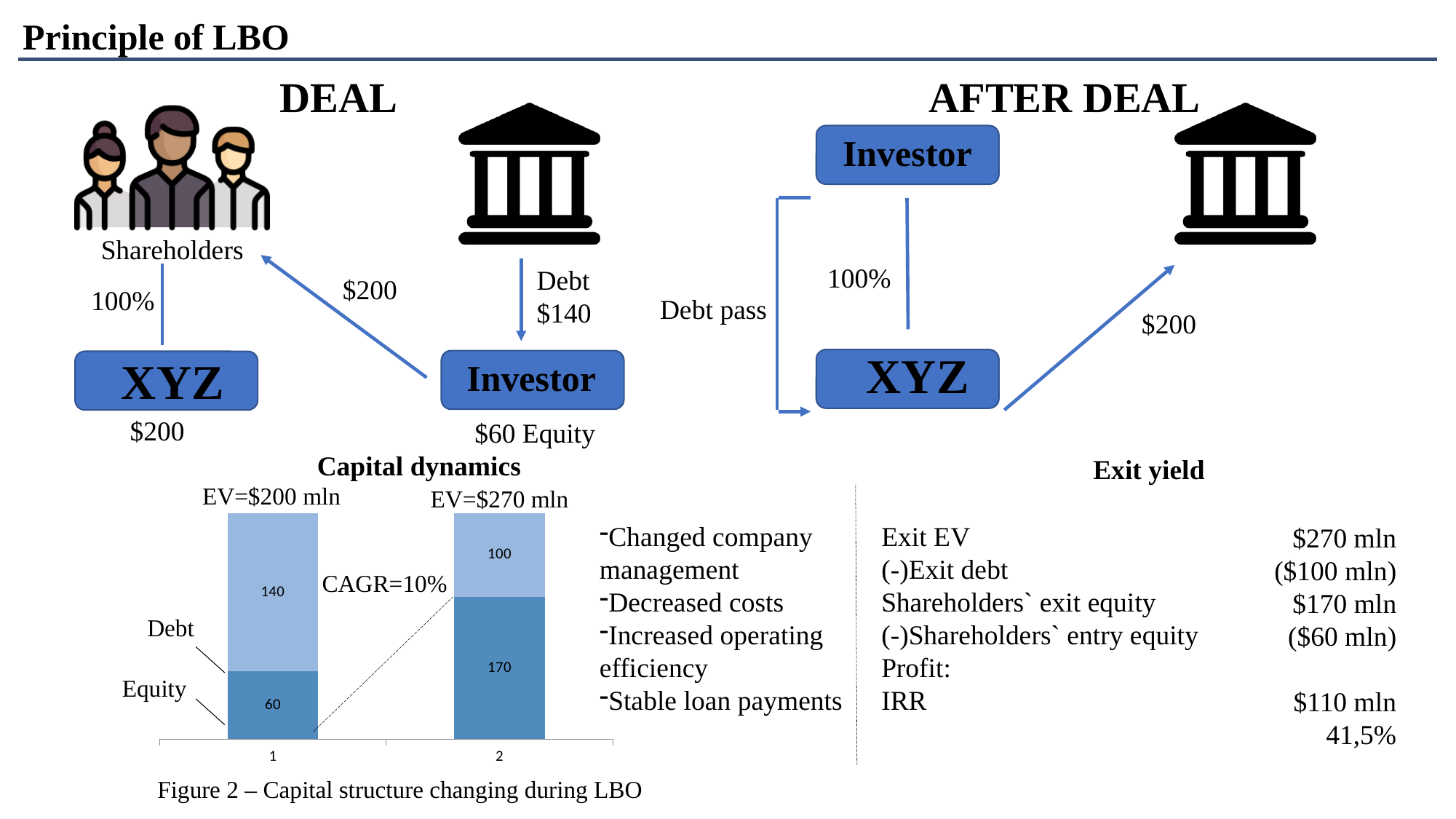
In the Capital dynamics chart, what is the Equity value for bar 1? 60 In the Capital dynamics chart, which bar has the larger Equity value, bar 1 or bar 2? bar 2 In the Capital dynamics chart, what is the total of bar 2 (EV)? $270 mln In the Capital dynamics chart, how much does Equity increase from bar 1 to bar 2? 110 In the Capital dynamics chart, what is the Debt value for bar 1? 140 In the Capital dynamics chart, what is the total of bar 1 (EV)? $200 mln In the Capital dynamics chart, what is the Equity value for bar 2? 170 In the Capital dynamics chart, how much does Debt decrease from bar 1 to bar 2? 40 What CAGR is annotated between the two bars in the Capital dynamics chart? 10% In the Capital dynamics chart, what is the Debt value for bar 2? 100 What type of chart is shown in the Capital dynamics figure? stacked bar chart How many bars are plotted in the Capital dynamics chart? 2